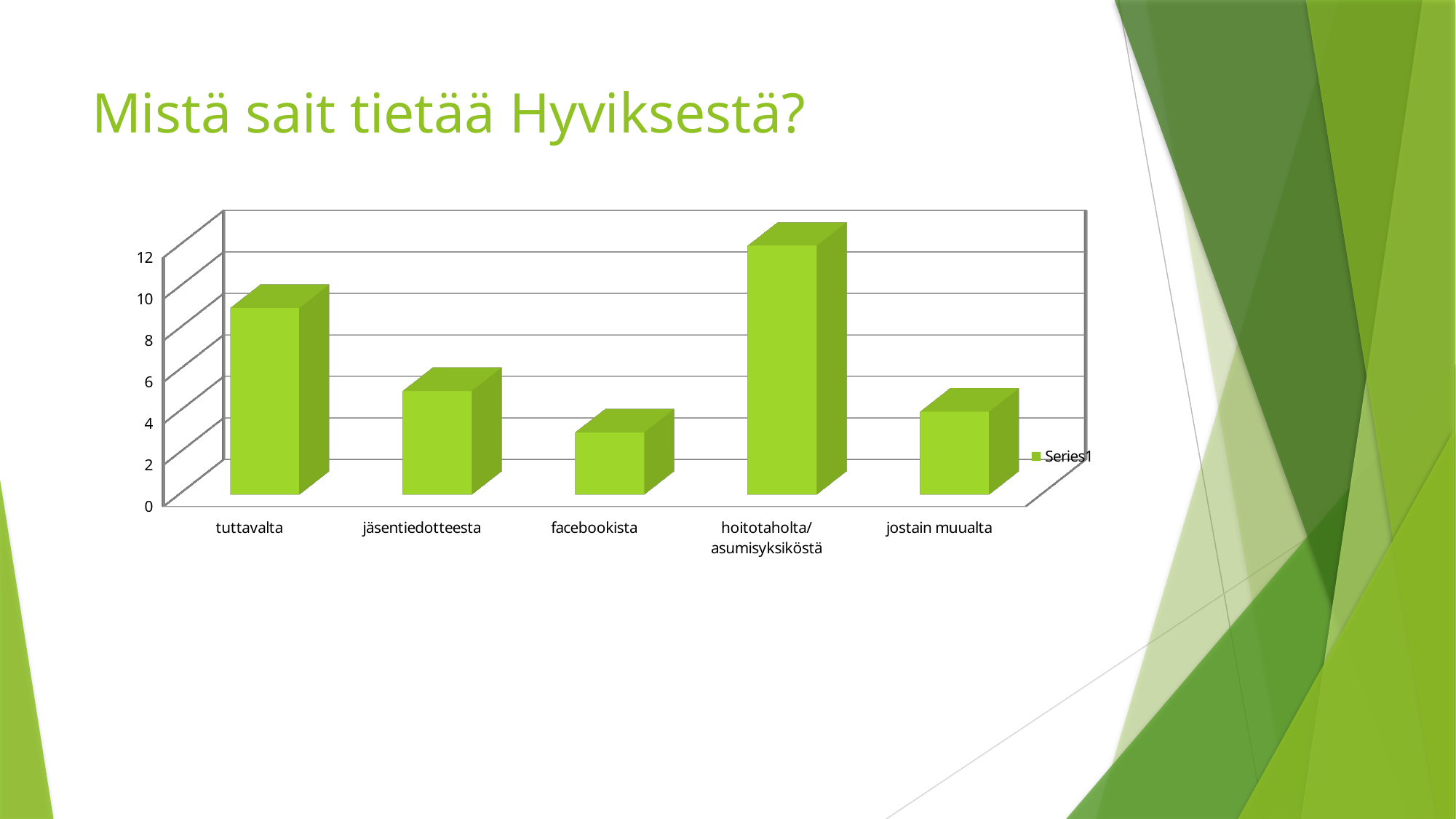
Is the value for tuttavalta greater or less than 6? greater How many series does the legend list? 1 Which category has the lowest bar? facebookista What is the title of the slide containing the chart? Mistä sait tietää Hyviksestä? What is the name of the series shown in the legend? Series1 Is the value for hoitotaholta/asumisyksiköstä greater or less than 10? greater Which is larger, the value for tuttavalta or the value for jäsentiedotteesta? tuttavalta What kind of chart is shown on the slide? bar chart Is the value for facebookista greater or less than 6? less How many categories are shown on the x axis of the chart? 5 Which category has the highest bar? hoitotaholta/asumisyksiköstä